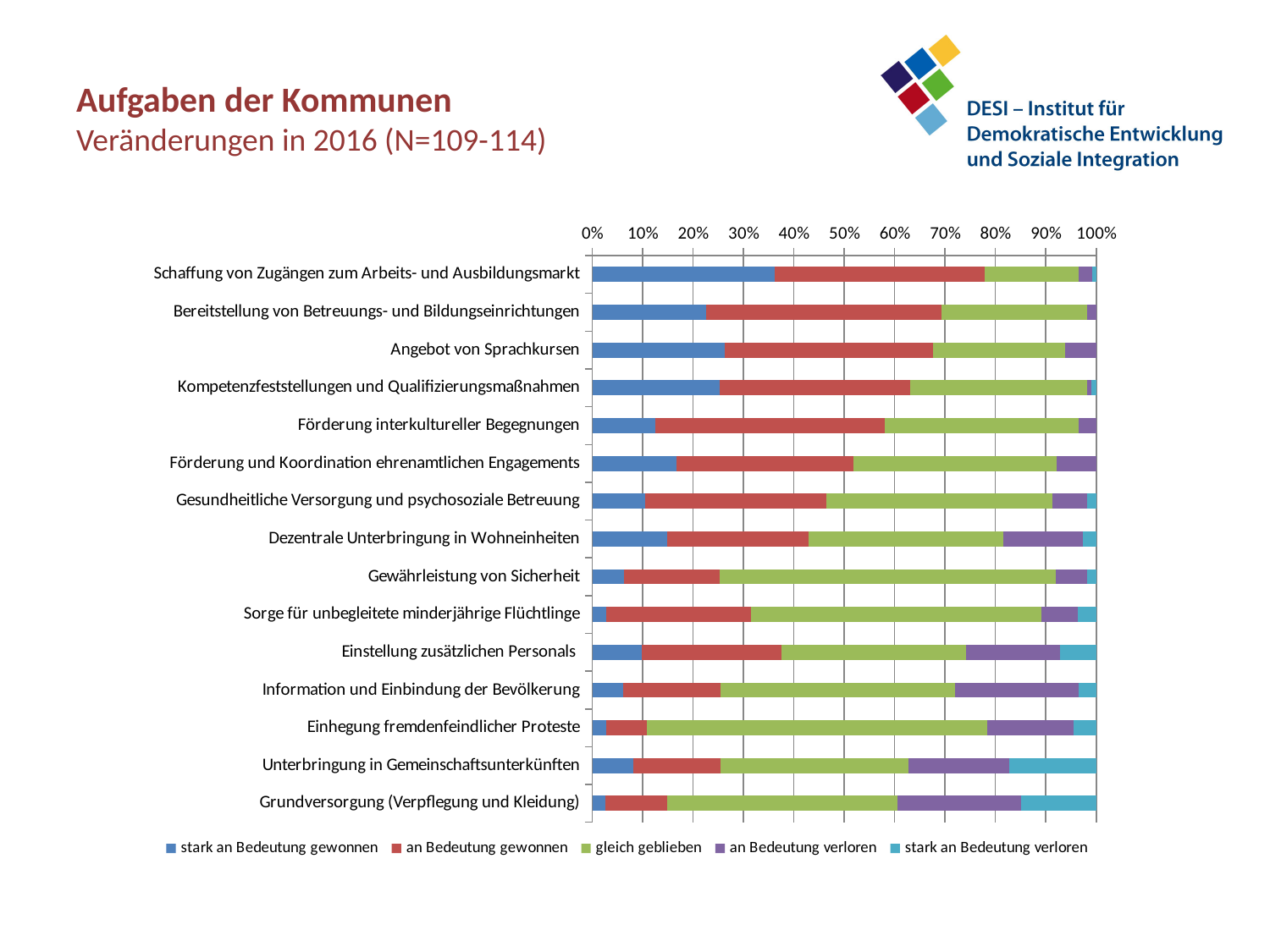
What is the first series listed in the chart legend? stark an Bedeutung gewonnen Which has a larger 'stark an Bedeutung gewonnen' share: 'Schaffung von Zugängen zum Arbeits- und Ausbildungsmarkt' or 'Angebot von Sprachkursen'? Schaffung von Zugängen zum Arbeits- und Ausbildungsmarkt Is the 'stark an Bedeutung gewonnen' share for 'Förderung interkultureller Begegnungen' greater or less than 20%? less What kind of chart is shown on the slide? Stacked bar chart Which category has the smallest 'an Bedeutung gewonnen' segment? Einhegung fremdenfeindlicher Proteste Is the 'stark an Bedeutung gewonnen' share for 'Gewährleistung von Sicherheit' greater or less than 10%? less How many categories (tasks) are listed on the vertical axis of the chart? 15 Is the 'stark an Bedeutung gewonnen' share for 'Schaffung von Zugängen zum Arbeits- und Ausbildungsmarkt' greater or less than 30%? greater Which category has the largest 'stark an Bedeutung gewonnen' segment? Schaffung von Zugängen zum Arbeits- und Ausbildungsmarkt What is the title of the slide containing the chart? Aufgaben der Kommunen How many series does the legend of the chart list? 5 Which has a larger 'gleich geblieben' segment: 'Gewährleistung von Sicherheit' or 'Schaffung von Zugängen zum Arbeits- und Ausbildungsmarkt'? Gewährleistung von Sicherheit